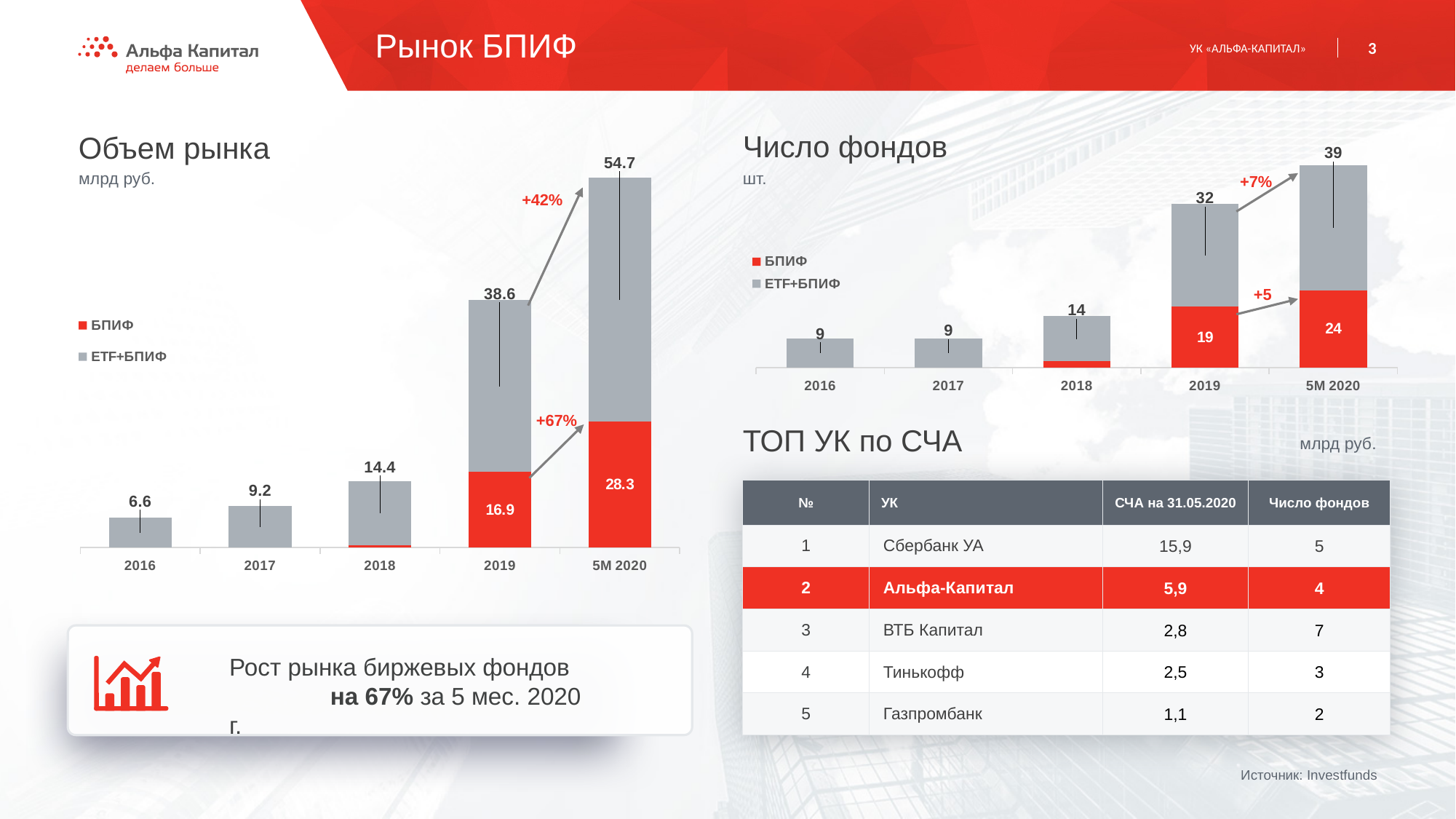
On the 'Число фондов' chart, do the total values rise or fall from 2016 to 5M 2020? Rise On the 'Объем рынка' chart, what is the value labelled at the top of the bar for 5M 2020? 54.7 On the 'Число фондов' chart, what is the БПИФ value for 5M 2020? 24 On the 'Число фондов' chart, what is the total value for 2018? 14 On the 'Число фондов' chart, how many periods are shown on the x axis? 5 On the 'Объем рынка' chart, what kind of chart is shown? Stacked bar chart On the 'Число фондов' chart, what is the difference between the БПИФ values for 5M 2020 and 2019? 5 On the 'Объем рынка' chart, which year has the lowest total value? 2016 On the 'Объем рынка' chart, how many series does the legend list? 2 On the 'Объем рынка' chart, what is the difference between the total for 5M 2020 and the total for 2019? 16.1 On the 'Число фондов' chart, which period has the highest total value? 5M 2020 On the 'Объем рынка' chart, what is the БПИФ value for 2019? 16.9